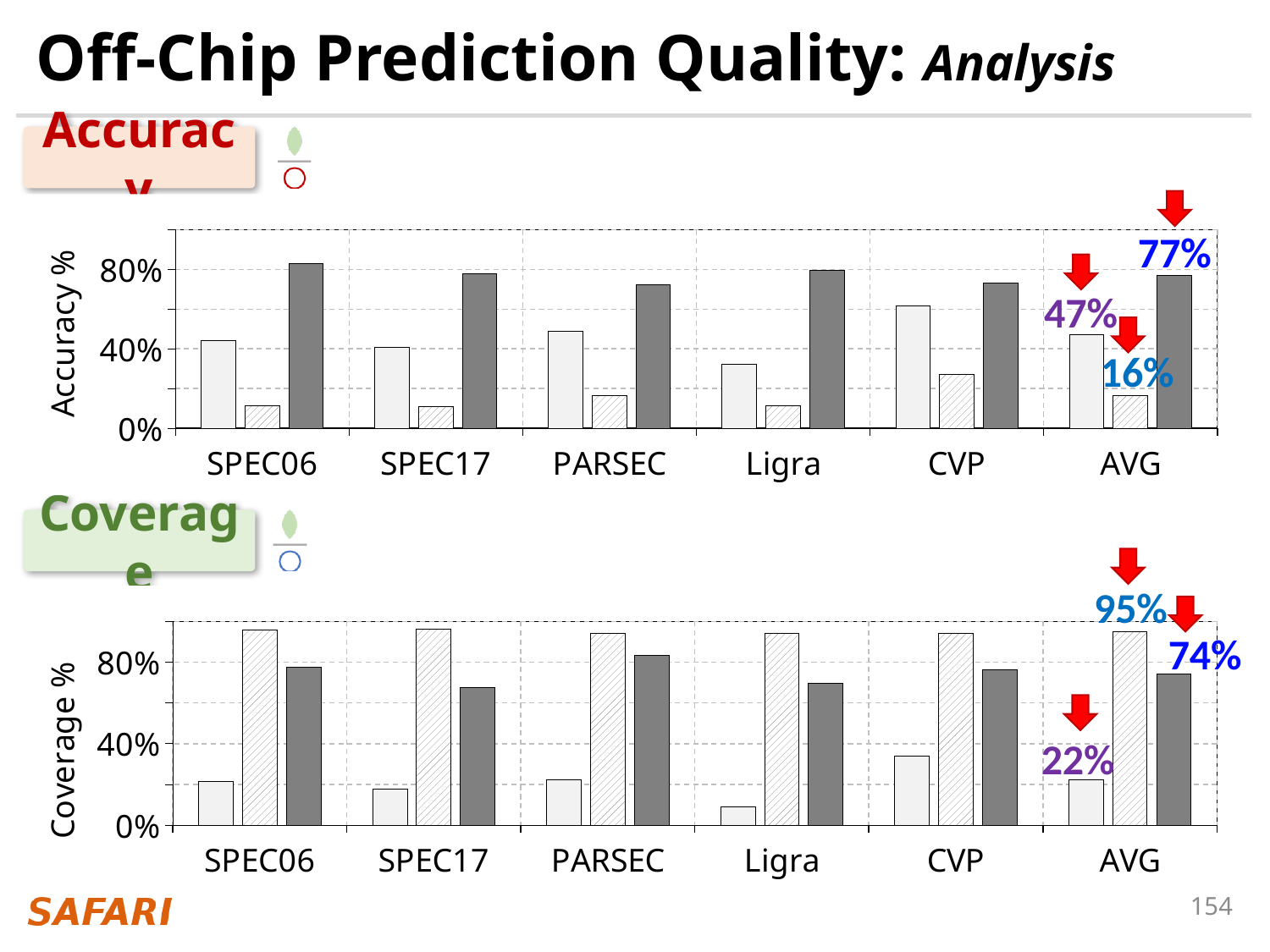
What kind of chart is the Coverage chart? bar chart In the Coverage chart, which category has the lowest light bar? Ligra In the Coverage chart, what is the difference between the labelled hatched bar (95%) and the labelled dark gray bar (74%) for AVG? 21 percentage points In the Coverage chart, which is larger for AVG: the hatched bar or the dark gray bar? the hatched bar In the Accuracy chart, what is the labelled value of the dark gray bar for AVG? 77% In the Coverage chart, what is the labelled value of the light bar for AVG? 22% In the Accuracy chart, what is the labelled value of the hatched bar for AVG? 16% In the Coverage chart, what is the labelled value of the hatched bar for AVG? 95% In the Accuracy chart, what is the difference between the labelled dark gray bar (77%) and the labelled light bar (47%) for AVG? 30 percentage points In the Accuracy chart, is the value of the light bar for Ligra greater or less than 40%? less What is the y-axis title of the top chart? Accuracy % How many categories are shown on the x axis of the Accuracy chart? 6